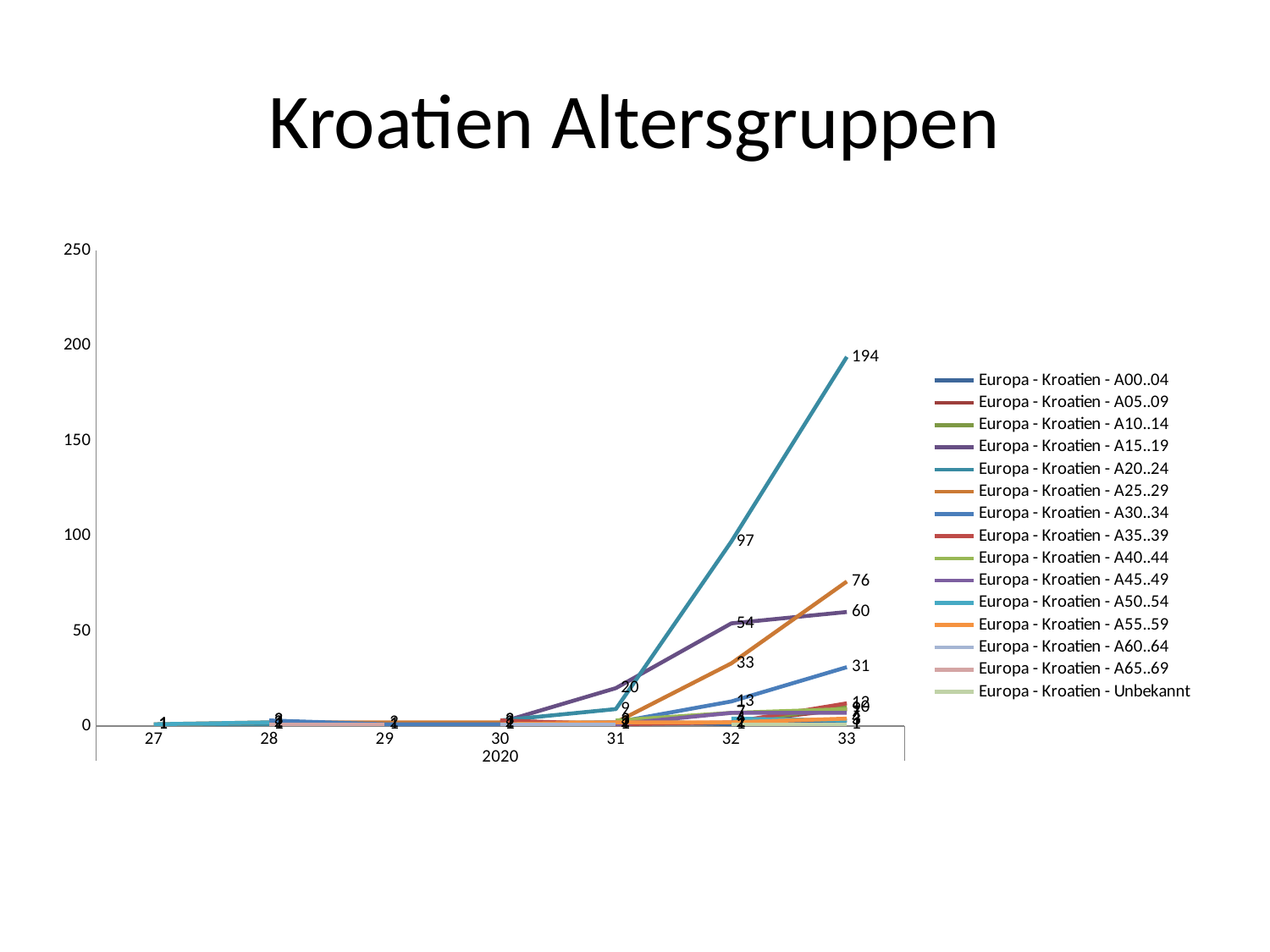
What is the value for Europa - Kroatien - A25..29 at week 33? 76 How many series does the legend list? 15 What is the value for Europa - Kroatien - A20..24 at week 33? 194 What is the value for Europa - Kroatien - A15..19 at week 33? 60 Is the value for Europa - Kroatien - A20..24 at week 33 greater or less than 150? greater What is the value for Europa - Kroatien - A20..24 at week 32? 97 What kind of chart is shown on the slide? line chart What is the difference between the week 33 values of Europa - Kroatien - A20..24 and Europa - Kroatien - A25..29? 118 Does the value for Europa - Kroatien - A20..24 rise or fall from week 31 to week 33? rise Which series has the highest value at week 33? Europa - Kroatien - A20..24 At week 33, which is larger: Europa - Kroatien - A15..19 or Europa - Kroatien - A25..29? Europa - Kroatien - A25..29 How many week values are shown along the x axis? 7